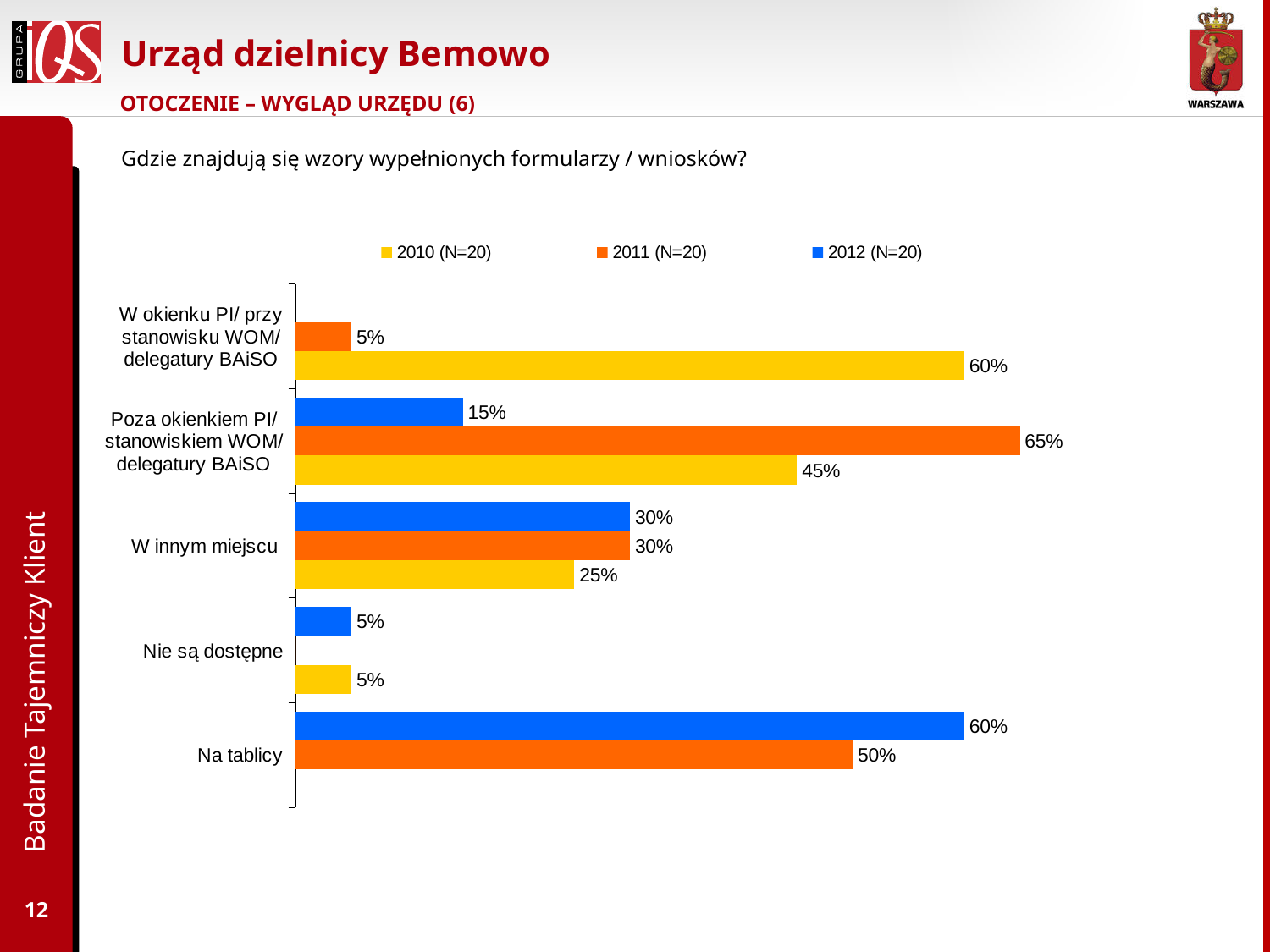
Which colour represents the 2012 (N=20) series in the legend? blue What is the difference between the 2011 (N=20) and 2010 (N=20) values for 'Poza okienkiem PI/ stanowiskiem WOM/ delegatury BAiSO'? 20% What is the value for 2010 (N=20) for 'W okienku PI/ przy stanowisku WOM/ delegatury BAiSO'? 60% Which category has the highest value for 2011 (N=20)? Poza okienkiem PI/ stanowiskiem WOM/ delegatury BAiSO What type of chart is shown on the slide? bar chart How many categories are shown on the chart? 5 What is the value for 2010 (N=20) for 'W innym miejscu'? 25% How many series does the legend list? 3 For 'Na tablicy', which is larger: the 2012 (N=20) value or the 2011 (N=20) value? 2012 (N=20) Which category has the lowest value for 2012 (N=20) among those with a bar shown? Nie są dostępne What is the value for 2011 (N=20) for 'Poza okienkiem PI/ stanowiskiem WOM/ delegatury BAiSO'? 65% What is the value for 2012 (N=20) for 'Na tablicy'? 60%